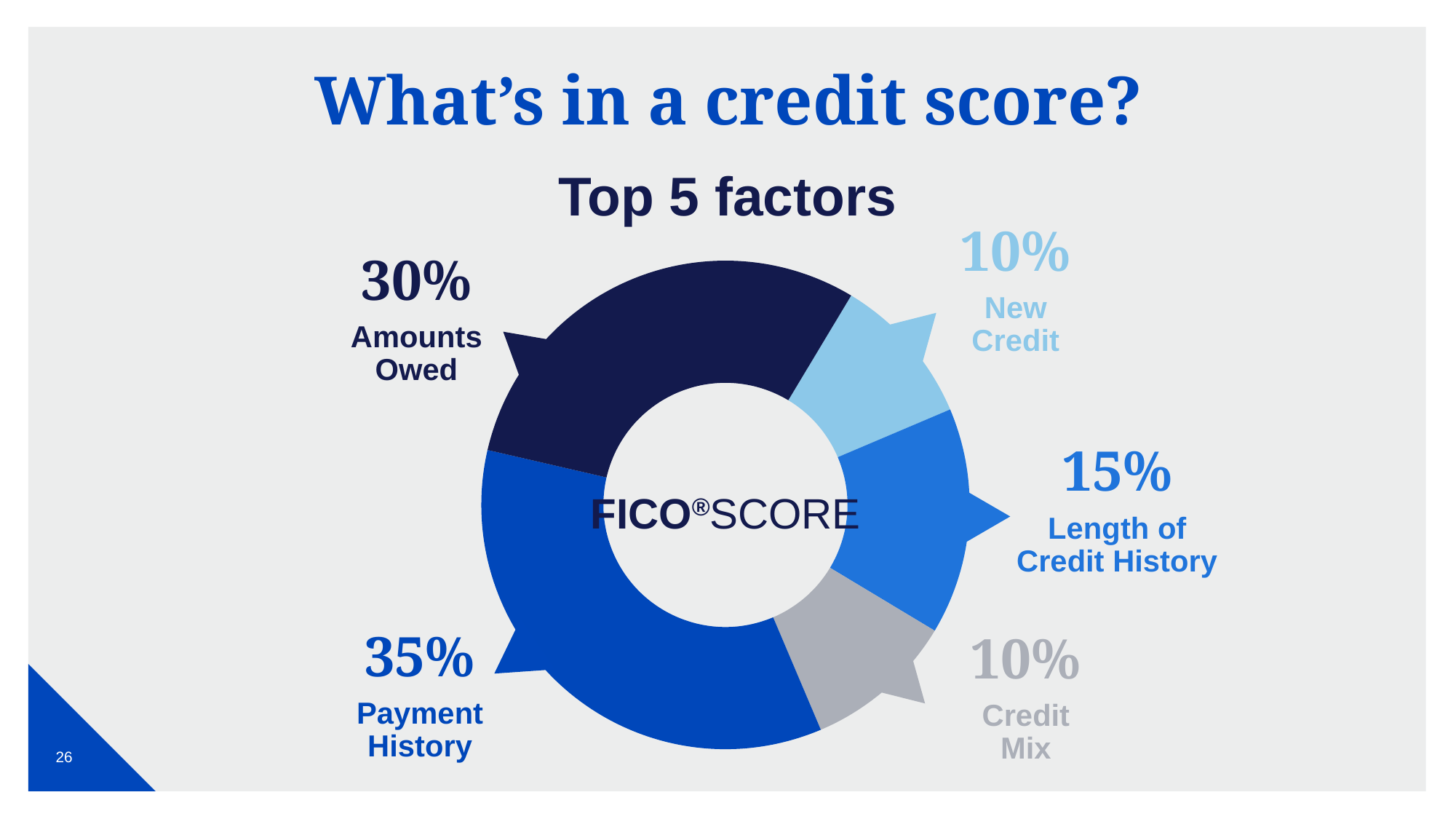
What share of the FICO Score does Amounts Owed account for? 30% What text appears in the centre of the chart? FICO® SCORE What kind of chart is shown on the slide? Pie chart (donut) What is the difference between the shares for Payment History and Amounts Owed? 5% What share of the FICO Score does Payment History account for? 35% Which is larger, the share for Amounts Owed or the share for Length of Credit History? Amounts Owed What is the difference between the shares for Length of Credit History and Credit Mix? 5% What share of the FICO Score does Length of Credit History account for? 15% Which factor has the largest share of the FICO Score? Payment History What share of the FICO Score does New Credit account for? 10% How many factors are shown in the chart? 5 What is the combined share of New Credit and Credit Mix? 20%